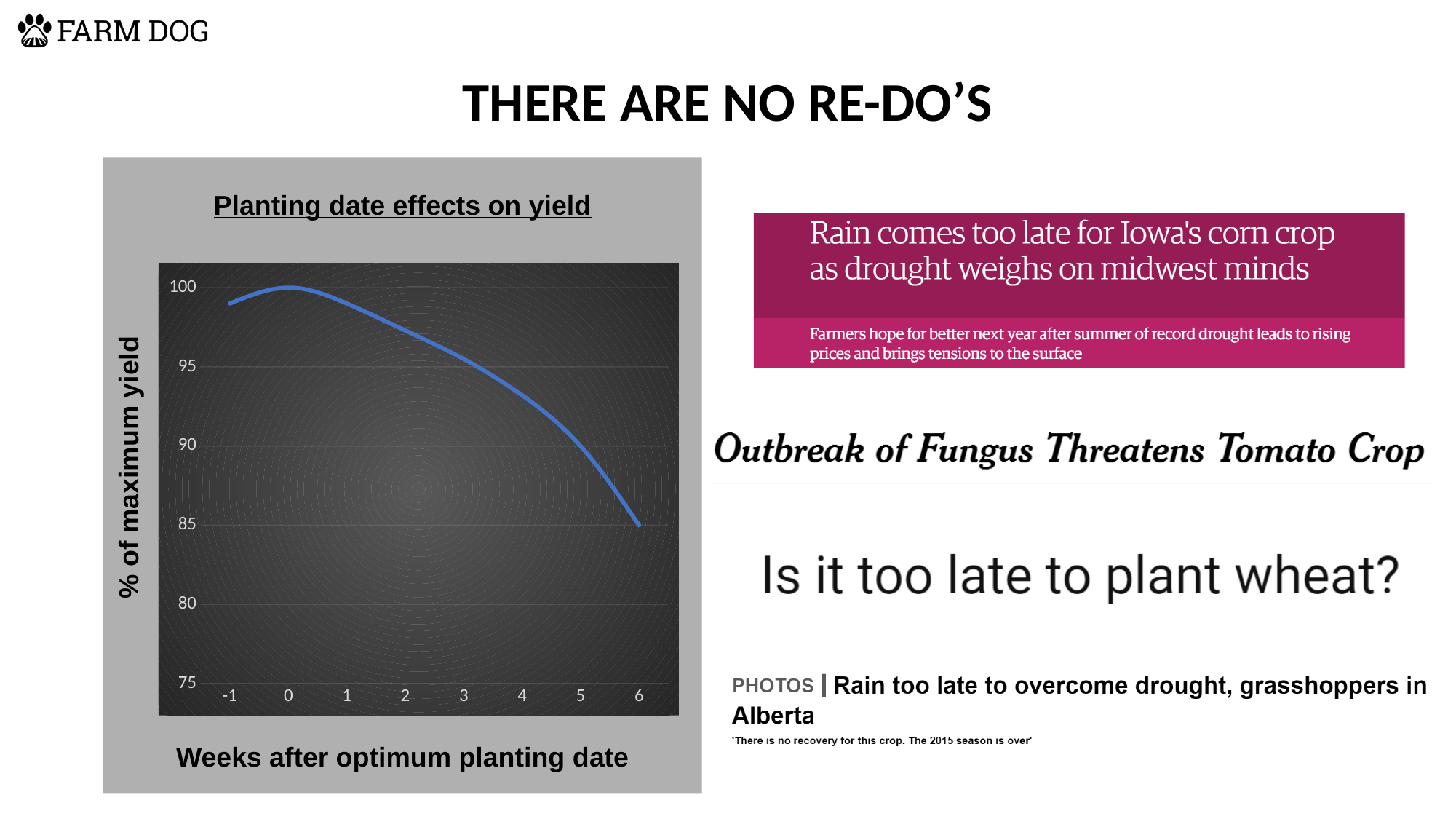
At how many weeks after the optimum planting date is the line at its lowest value? 6 Is the % of maximum yield at 4 weeks after the optimum planting date greater or less than 90? greater What is the title of the chart on the slide? Planting date effects on yield What kind of chart is shown under the title "Planting date effects on yield"? line chart What is the % of maximum yield at 0 weeks after the optimum planting date? 100 At how many weeks after the optimum planting date does the line reach its highest value? 0 Is the % of maximum yield at 5 weeks after the optimum planting date greater or less than 95? less What is the label of the y axis of the chart? % of maximum yield What is the % of maximum yield at 6 weeks after the optimum planting date? 85 Is the % of maximum yield at 2 weeks after the optimum planting date greater or less than 95? greater Does the % of maximum yield rise or fall as the weeks after the optimum planting date increase from 0 to 6? fall Which has a higher % of maximum yield: 1 week or 5 weeks after the optimum planting date? 1 week